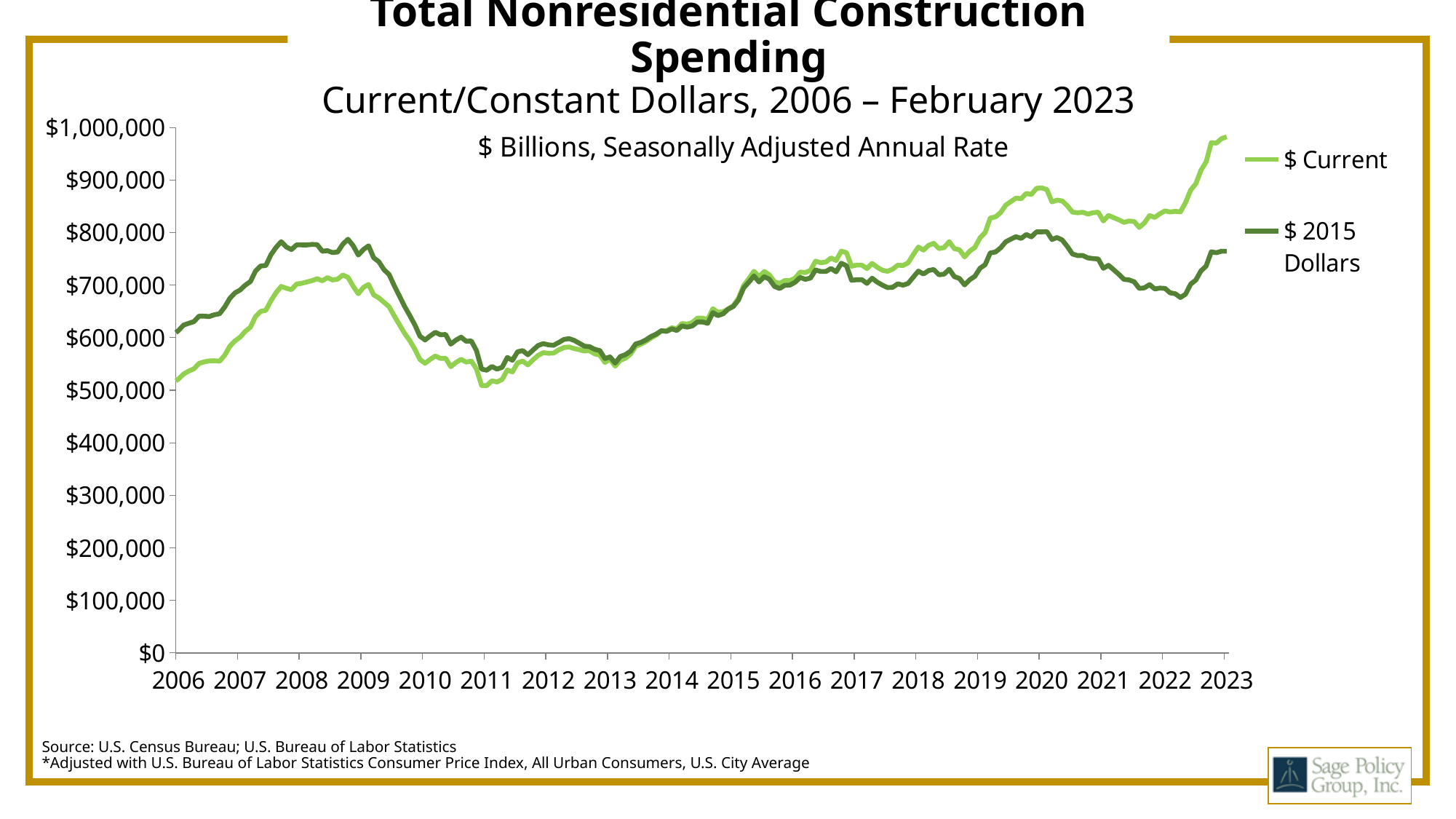
What are the two series named in the legend? $ Current and $ 2015 Dollars Does the $ Current series rise or fall between 2008 and 2011? fall How many year labels are shown on the x axis? 18 Is the value for $ Current at the end of the series in 2023 greater or less than $900,000? greater Is the value for $ Current at the start of 2006 greater or less than $600,000? less Is the value for $ 2015 Dollars at the end of the series in 2023 greater or less than $800,000? less How many series does the legend list? 2 At the start of 2006, which series is higher, $ Current or $ 2015 Dollars? $ 2015 Dollars What kind of chart is shown on the slide? line chart What is the subtitle describing the units of the chart? $ Billions, Seasonally Adjusted Annual Rate At the end of the series in 2023, which series is higher, $ Current or $ 2015 Dollars? $ Current